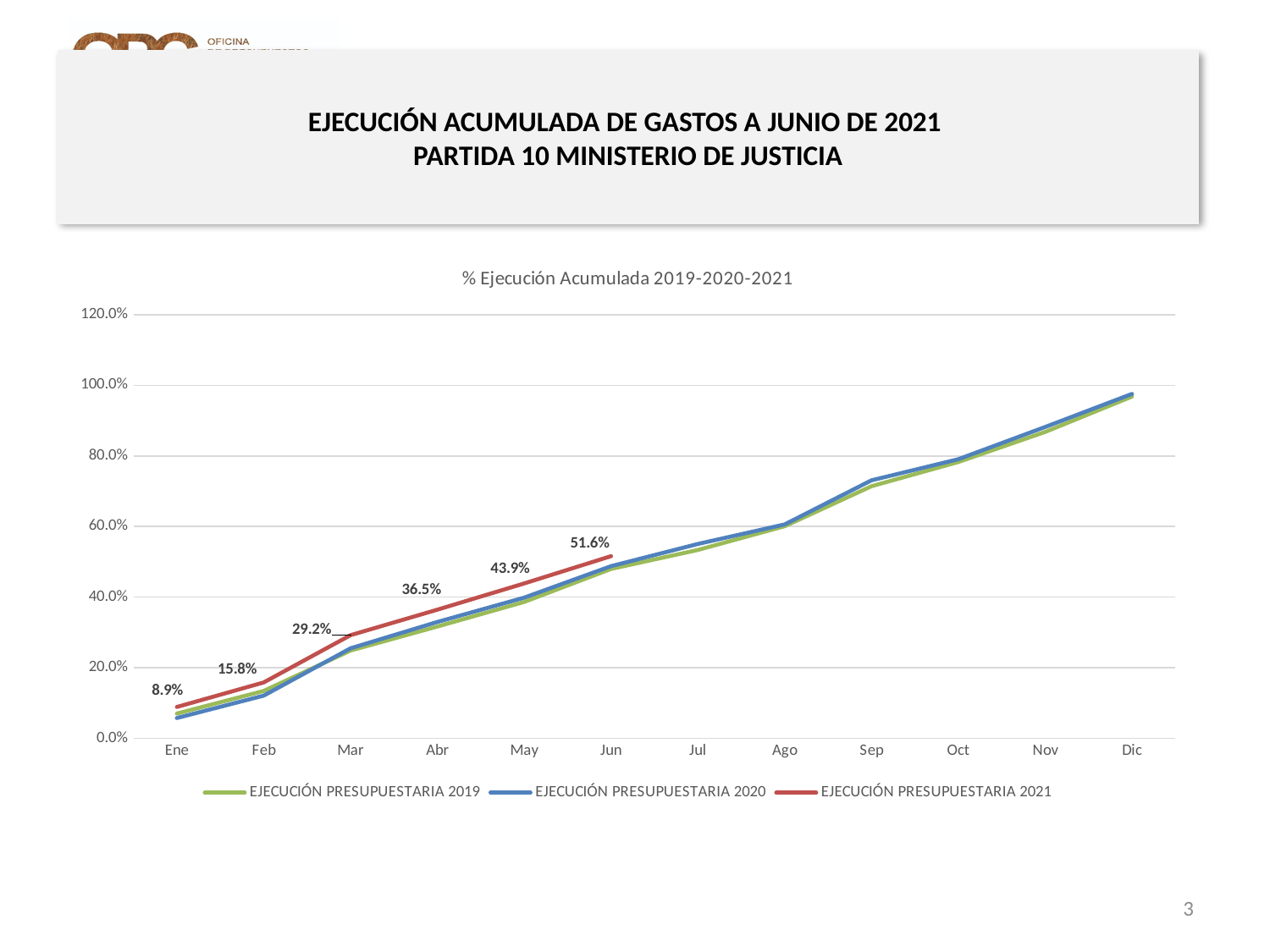
Is the value for EJECUCIÓN PRESUPUESTARIA 2019 in Sep greater or less than 80.0%? less By how many percentage points did EJECUCIÓN PRESUPUESTARIA 2021 increase from May to Jun? 7.7 percentage points Do the values of EJECUCIÓN PRESUPUESTARIA 2020 rise or fall from Ene to Dic? Rise In which month does EJECUCIÓN PRESUPUESTARIA 2021 reach its highest labelled value? Jun What is the value of EJECUCIÓN PRESUPUESTARIA 2021 in Mar? 29.2% What is the title of the chart? % Ejecución Acumulada 2019-2020-2021 By how many percentage points did EJECUCIÓN PRESUPUESTARIA 2021 increase from Ene to Feb? 6.9 percentage points How many months are shown on the x axis? 12 What is the value of EJECUCIÓN PRESUPUESTARIA 2021 in Jun? 51.6% What is the value of EJECUCIÓN PRESUPUESTARIA 2021 in Ene? 8.9% How many series does the legend list? 3 What kind of chart is shown on the slide? Line chart